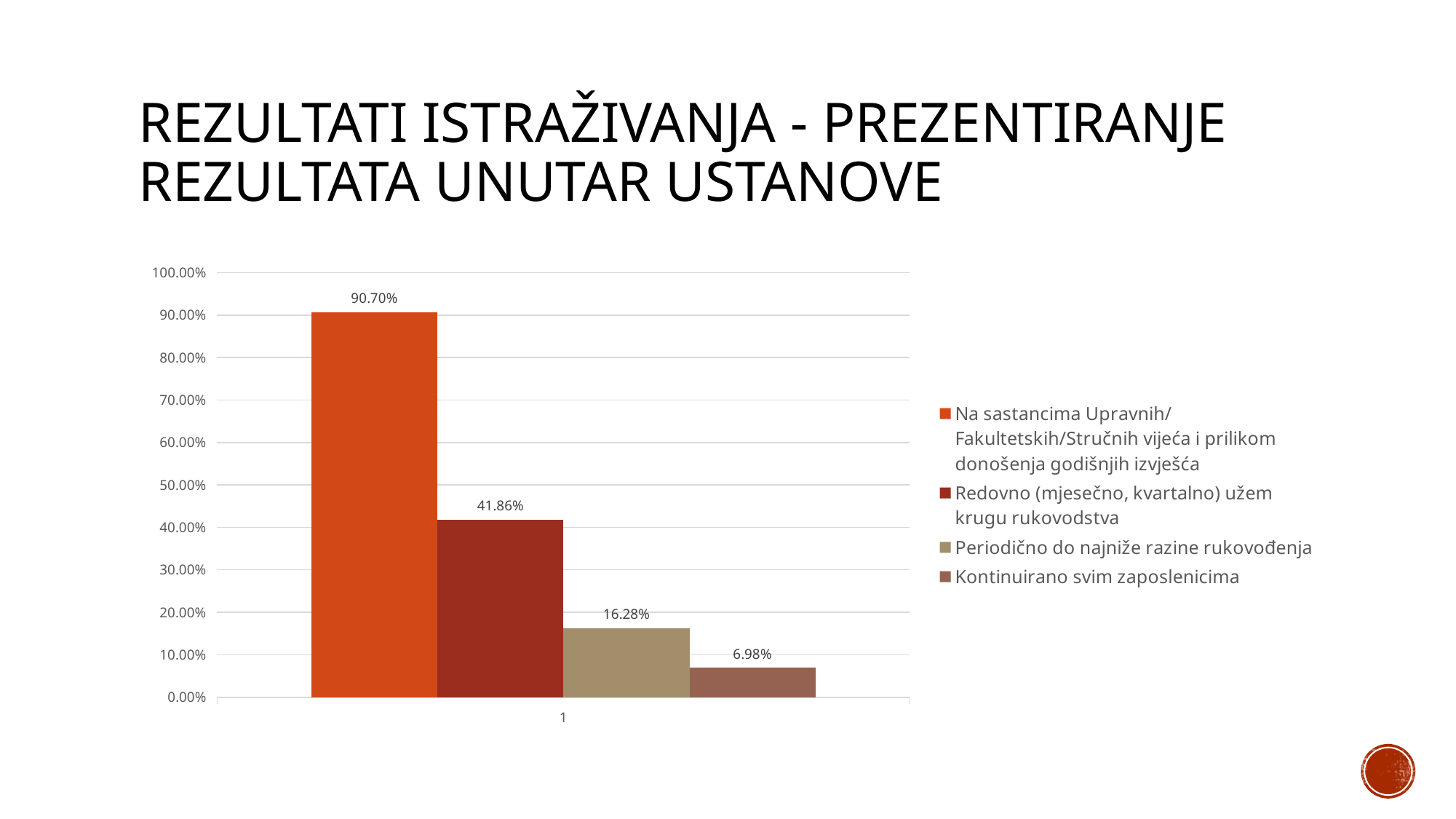
What is the value for 'Redovno (mjesečno, kvartalno) užem krugu rukovodstva'? 41.86% Is the value for 'Redovno (mjesečno, kvartalno) užem krugu rukovodstva' greater or less than 50.00%? less Which is larger: the value for 'Redovno (mjesečno, kvartalno) užem krugu rukovodstva' or for 'Periodično do najniže razine rukovođenja'? Redovno (mjesečno, kvartalno) užem krugu rukovodstva What is the difference between the values for 'Na sastancima Upravnih/Fakultetskih/Stručnih vijeća i prilikom donošenja godišnjih izvješća' and 'Redovno (mjesečno, kvartalno) užem krugu rukovodstva'? 48.84% Which series has the highest value? Na sastancima Upravnih/Fakultetskih/Stručnih vijeća i prilikom donošenja godišnjih izvješća What is the difference between the values for 'Periodično do najniže razine rukovođenja' and 'Kontinuirano svim zaposlenicima'? 9.30% How many series does the legend list? 4 What is the value for 'Kontinuirano svim zaposlenicima'? 6.98% What kind of chart is shown on the slide? Bar chart Which series has the lowest value? Kontinuirano svim zaposlenicima What is the value for 'Periodično do najniže razine rukovođenja'? 16.28% What is the value for 'Na sastancima Upravnih/Fakultetskih/Stručnih vijeća i prilikom donošenja godišnjih izvješća'? 90.70%